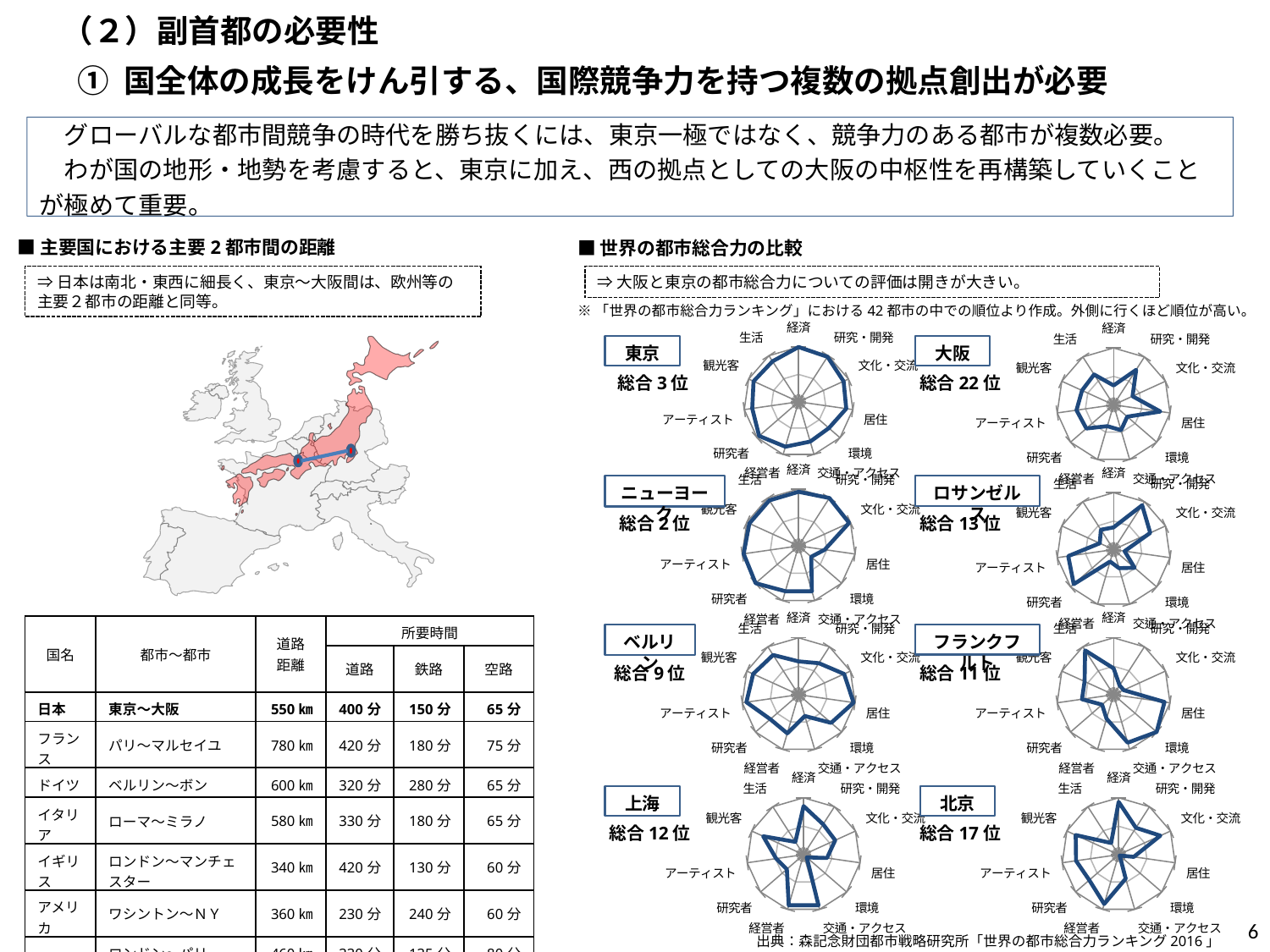
What is the difference in overall rank between 東京 (総合 3 位) and 大阪 (総合 22 位)? 19 In the 「世界の都市総合力の比較」 section, what overall rank (総合) is printed next to the 大阪 radar chart? 総合 22 位 What kind of chart is used in the 「世界の都市総合力の比較」 section to show each city's profile? Radar chart How many radar charts (cities) are shown in the 「世界の都市総合力の比較」 section? 8 What is the source cited for the radar charts in the 「世界の都市総合力の比較」 section? 森記念財団都市戦略研究所「世界の都市総合力ランキング 2016」 In the 「世界の都市総合力の比較」 section, what overall rank (総合) is printed next to the 北京 radar chart? 総合 17 位 Comparing the 東京 and 大阪 radar charts, which city scores higher on the 経済 axis? 東京 Among the eight cities in the 「世界の都市総合力の比較」 section, which city has the worst (lowest) overall rank? 大阪 In the 「世界の都市総合力の比較」 section, what overall rank (総合) is printed next to the 上海 radar chart? 総合 12 位 Comparing the 東京 and 大阪 radar charts, which city scores higher on the 研究・開発 axis? 東京 Among the eight cities in the 「世界の都市総合力の比較」 section, which city has the best (highest) overall rank? ニューヨーク In the 「世界の都市総合力の比較」 section, what overall rank (総合) is printed next to the 東京 radar chart? 総合 3 位